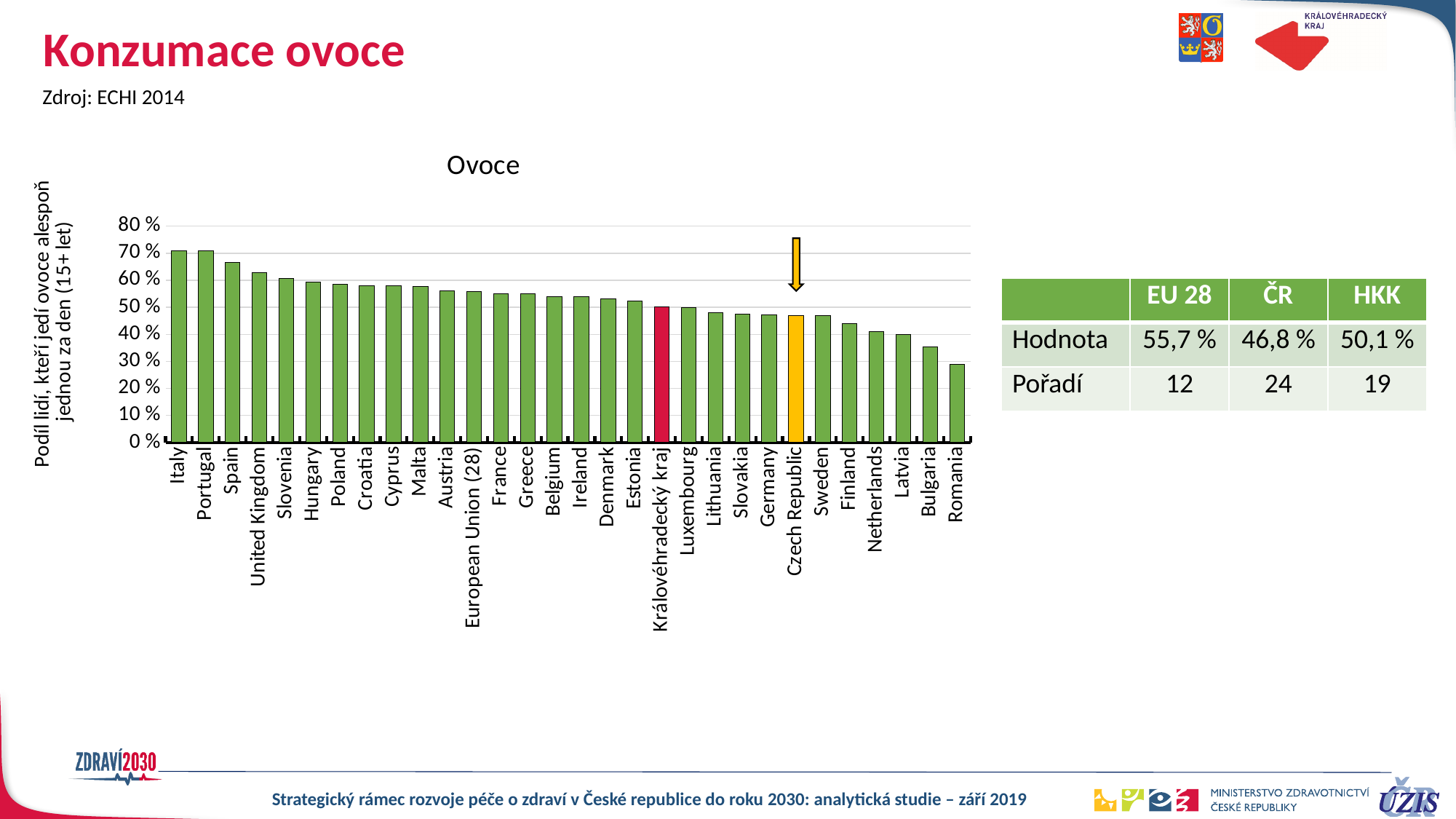
How many countries/regions are plotted in the "Ovoce" chart? 30 What is the value for Czech Republic (ČR) in the "Ovoce" chart, as given in the table? 46,8 % Which category has the lowest value in the "Ovoce" chart? Romania What kind of chart is shown under the title "Ovoce"? bar chart Is the value for Bulgaria in the "Ovoce" chart greater or less than 40 %? less What is the difference between the EU 28 value and the ČR value shown in the table? 8,9 % What colour is the bar for Czech Republic in the "Ovoce" chart? yellow/orange Do the bar values rise or fall from left to right along the x axis of the "Ovoce" chart? fall What is the value for European Union (28) in the "Ovoce" chart, as given in the table? 55,7 % In the "Ovoce" chart, which has the larger value, Spain or Latvia? Spain Is the value for Italy in the "Ovoce" chart greater or less than 60 %? greater What is the value for Královéhradecký kraj (HKK) in the "Ovoce" chart, as given in the table? 50,1 %